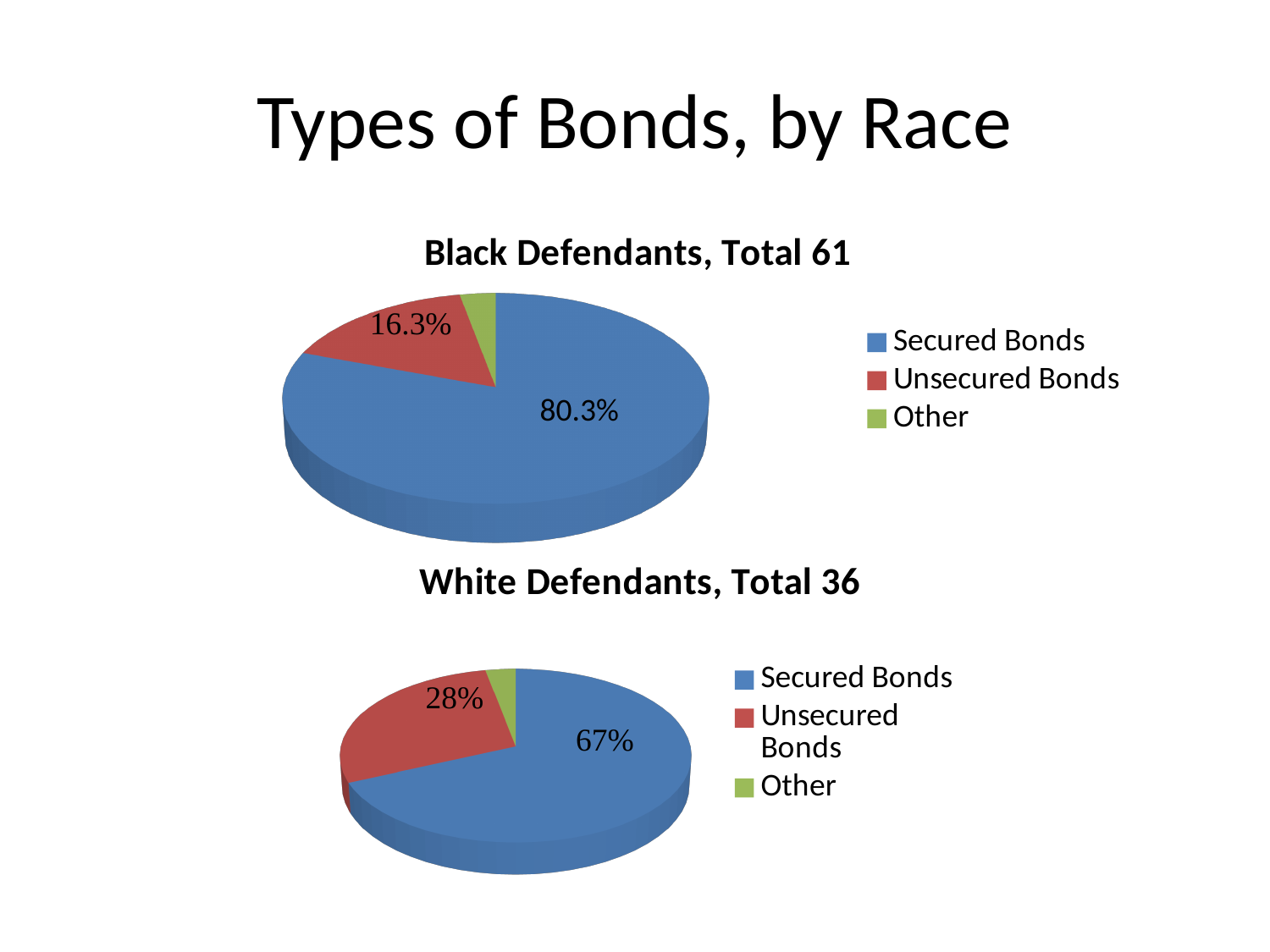
In the 'White Defendants, Total 36' chart, what share of the pie is Unsecured Bonds? 28% In the 'Black Defendants, Total 61' chart, what share of the pie is Unsecured Bonds? 16.3% How many categories does the legend of the 'White Defendants, Total 36' chart list? 3 In the 'White Defendants, Total 36' chart, what is the difference between the Secured Bonds and Unsecured Bonds shares? 39 percentage points In the 'Black Defendants, Total 61' chart, what share of the pie is Secured Bonds? 80.3% What kind of chart is the 'Black Defendants, Total 61' chart? Pie chart In the 'Black Defendants, Total 61' chart, which category has the largest slice? Secured Bonds In the 'Black Defendants, Total 61' chart, what colour is the Other slice? Green In the 'White Defendants, Total 36' chart, which category has the smallest slice? Other Which chart has the larger Unsecured Bonds share, 'Black Defendants, Total 61' or 'White Defendants, Total 36'? White Defendants, Total 36 In the 'Black Defendants, Total 61' chart, what is the difference between the Secured Bonds and Unsecured Bonds shares? 64 percentage points